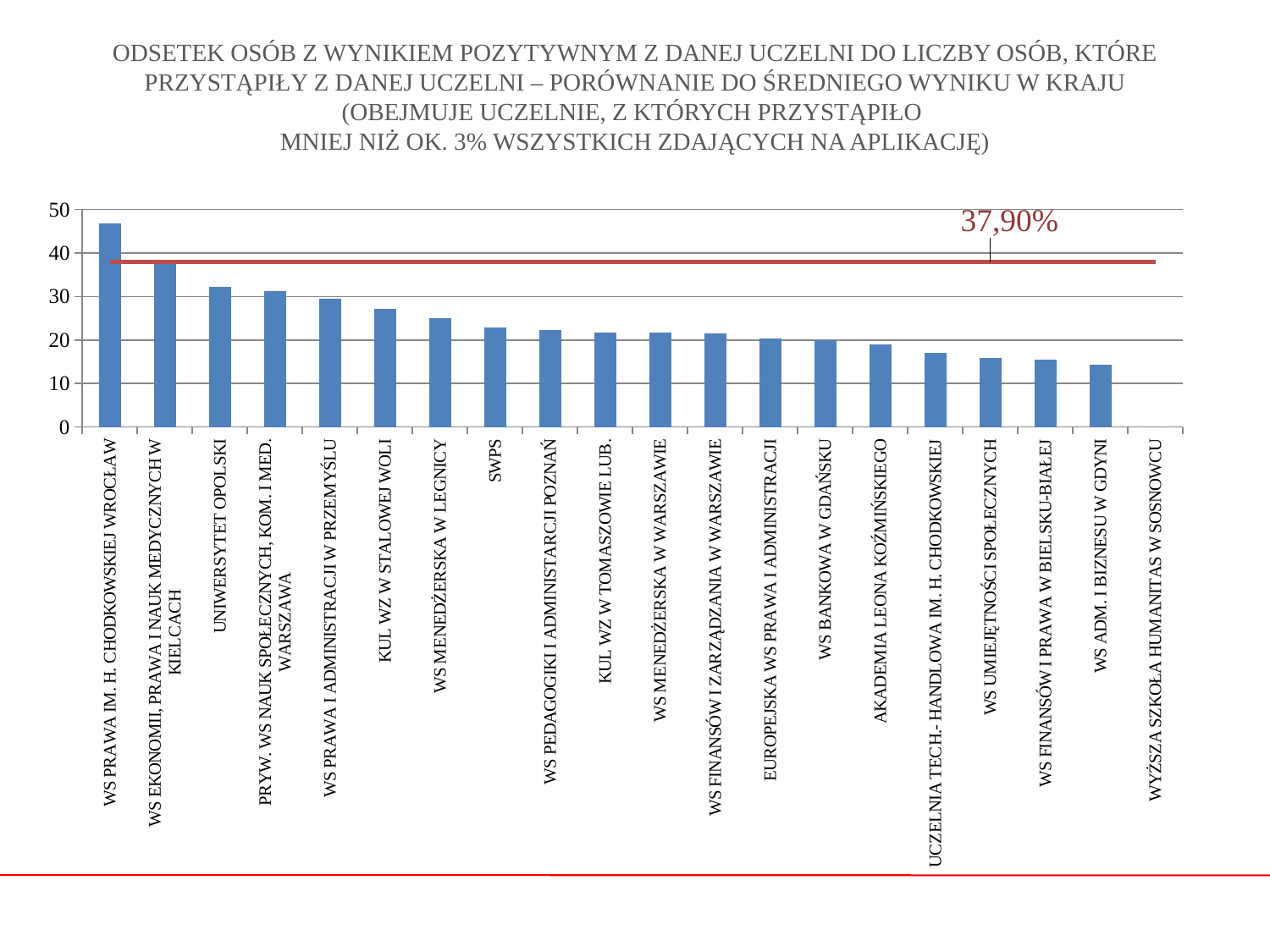
Is the value for WS ADM. I BIZNESU W GDYNI greater or less than 10? greater Which has the larger value, UNIWERSYTET OPOLSKI or SWPS? UNIWERSYTET OPOLSKI How many universities are listed along the x axis of the chart? 20 Is the value for UNIWERSYTET OPOLSKI greater or less than 30? greater Is the value for SWPS greater or less than 20? greater Do the bar values rise or fall from left to right along the x axis? fall Which university has the highest value in the chart? WS PRAWA IM. H. CHODKOWSKIEJ WROCŁAW What value is printed for the horizontal reference line (the national average)? 37,90% What kind of chart is shown on the slide? bar chart